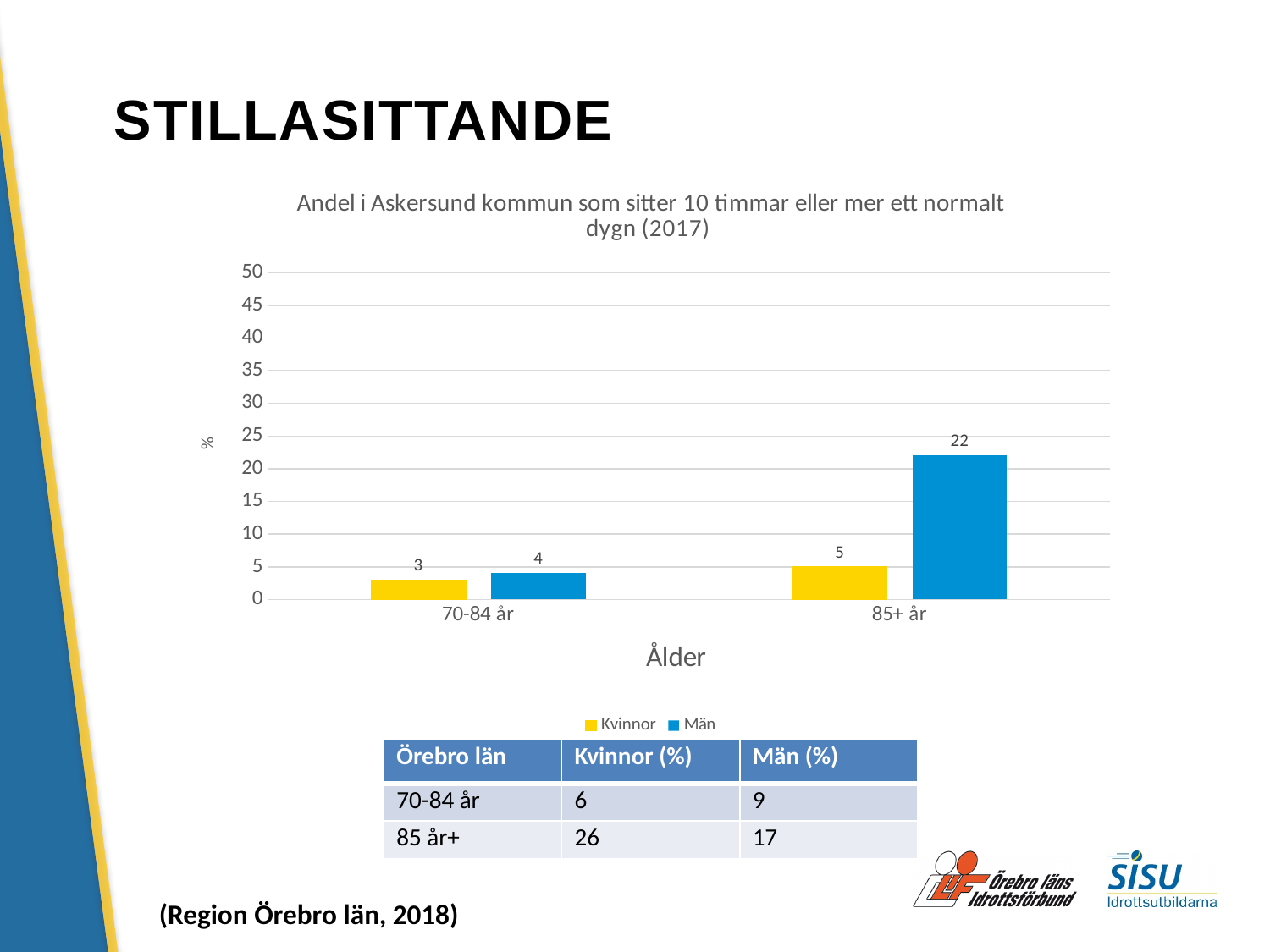
Is the value for Män in the 85+ år category greater or less than 20? greater What is the difference between the Män and Kvinnor values in the 85+ år category? 17 Which is larger in the 70-84 år category, Kvinnor or Män? Män How many age categories are shown on the x axis? 2 Which age category has the highest value for Män? 85+ år Which age category has the lowest value for Kvinnor? 70-84 år What is the value for Kvinnor in the 70-84 år category? 3 What kind of chart is shown on the slide? Bar chart What is the value for Män in the 70-84 år category? 4 What is the value for Män in the 85+ år category? 22 How many series does the legend list? 2 What is the value for Kvinnor in the 85+ år category? 5